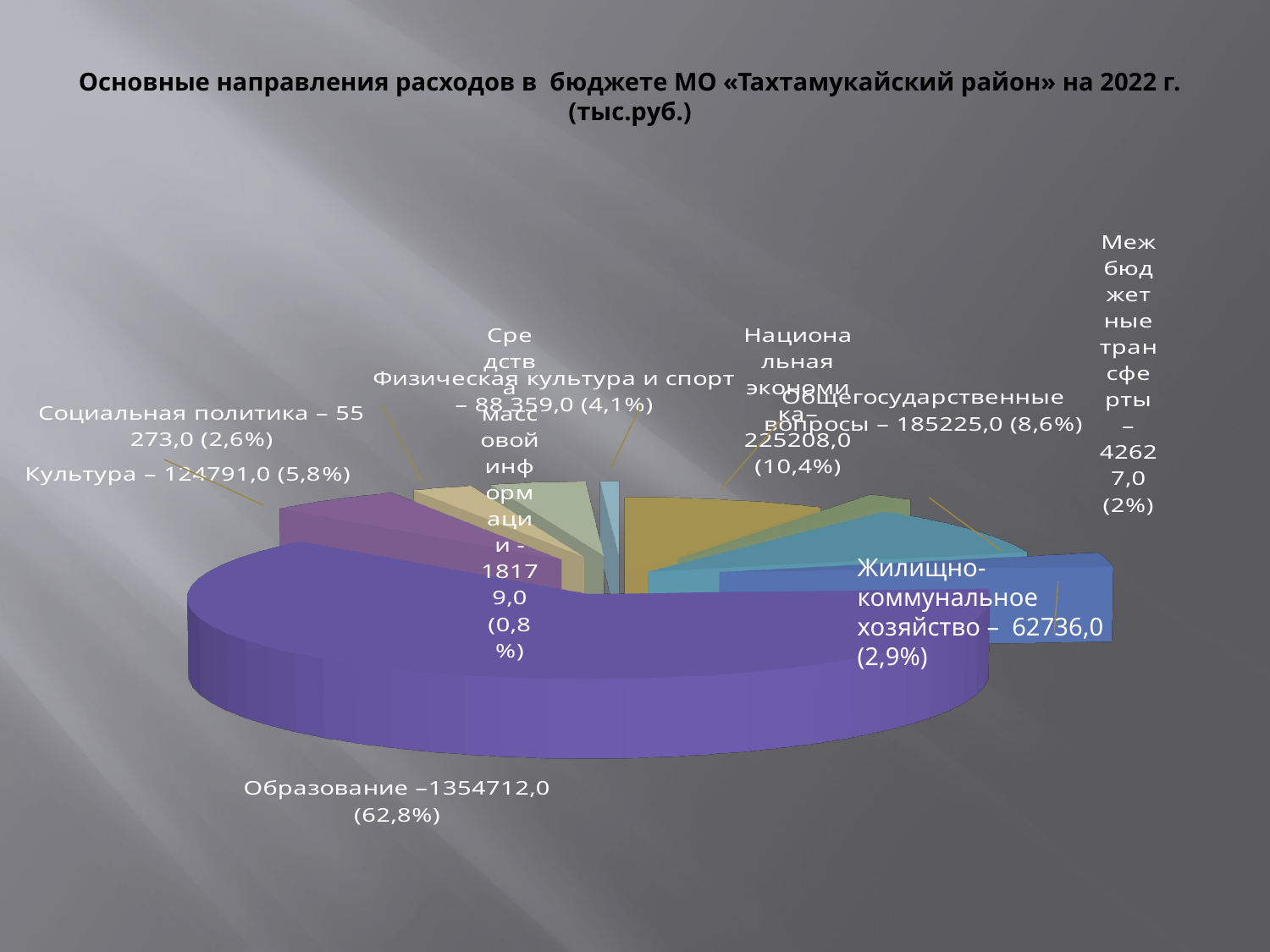
In what units are the values in the chart expressed, according to the title? тыс.руб. What is the value for Образование? 1354712,0 Which expenditure category has the smallest share of the budget? Средства массовой информации What is the difference between the values for Национальная экономика and Общегосударственные вопросы? 39983,0 How many expenditure categories (slices) does the pie chart show? 9 What share of the budget does Общегосударственные вопросы account for? 8,6% Which is larger: Национальная экономика or Общегосударственные вопросы? Национальная экономика Which expenditure category has the largest share of the budget? Образование What is the value for Национальная экономика? 225208,0 What is the value for Жилищно-коммунальное хозяйство? 62736,0 What share of the budget does Культура account for? 5,8% What kind of chart is shown on the slide? pie chart